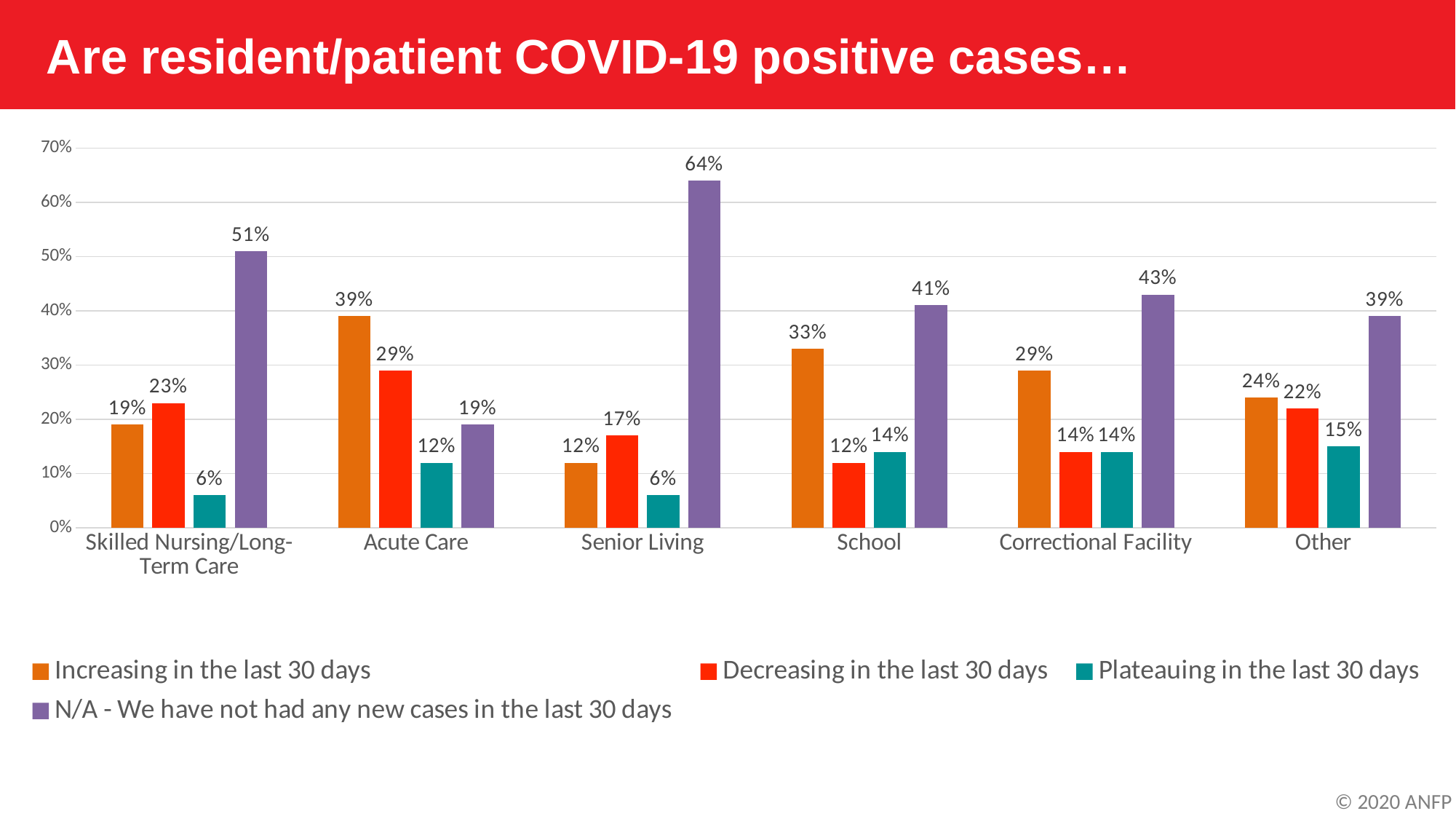
How many series does the legend list? 4 How many facility categories are shown on the x axis? 6 What is the title of the slide? Are resident/patient COVID-19 positive cases… What is the difference between the 'Decreasing in the last 30 days' values for Acute Care and School? 17% Which category has the lowest value for 'Increasing in the last 30 days'? Senior Living What colour represents 'Plateauing in the last 30 days' in the chart? Teal What kind of chart is shown on the slide? Bar chart Which is larger for Correctional Facility: 'Increasing in the last 30 days' or 'N/A - We have not had any new cases in the last 30 days'? N/A - We have not had any new cases in the last 30 days What percentage of School respondents reported cases plateauing in the last 30 days? 14% What percentage of Acute Care respondents reported cases increasing in the last 30 days? 39% Which category has the highest value for 'N/A - We have not had any new cases in the last 30 days'? Senior Living What is the value for 'N/A - We have not had any new cases in the last 30 days' for Senior Living? 64%